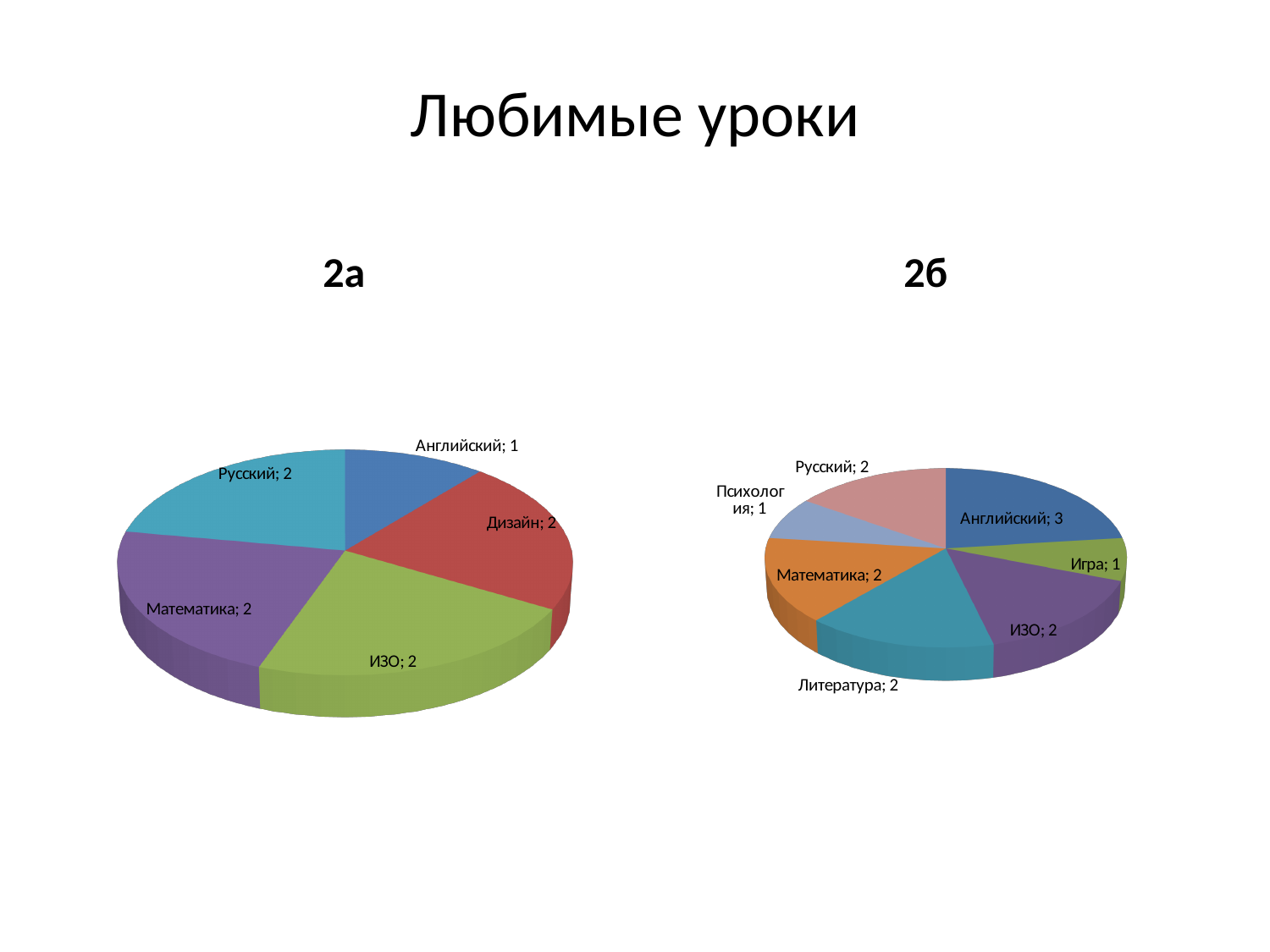
In the 2а chart, what is the value for Английский? 1 In the 2б chart, which is larger, the value for Математика or the value for Психология? Математика In the 2б chart, what is the value for Английский? 3 What kind of chart is the 2а chart? pie chart How many slices does the 2а chart have? 5 In the 2б chart, what is the difference between the values for Английский and Игра? 2 What is the title of the slide containing the two pie charts? Любимые уроки In the 2а chart, what is the value for Дизайн? 2 In the 2б chart, what is the value for Литература? 2 In the 2а chart, which subject has the lowest value? Английский In the 2б chart, which subject has the highest value? Английский How many slices does the 2б chart have? 7